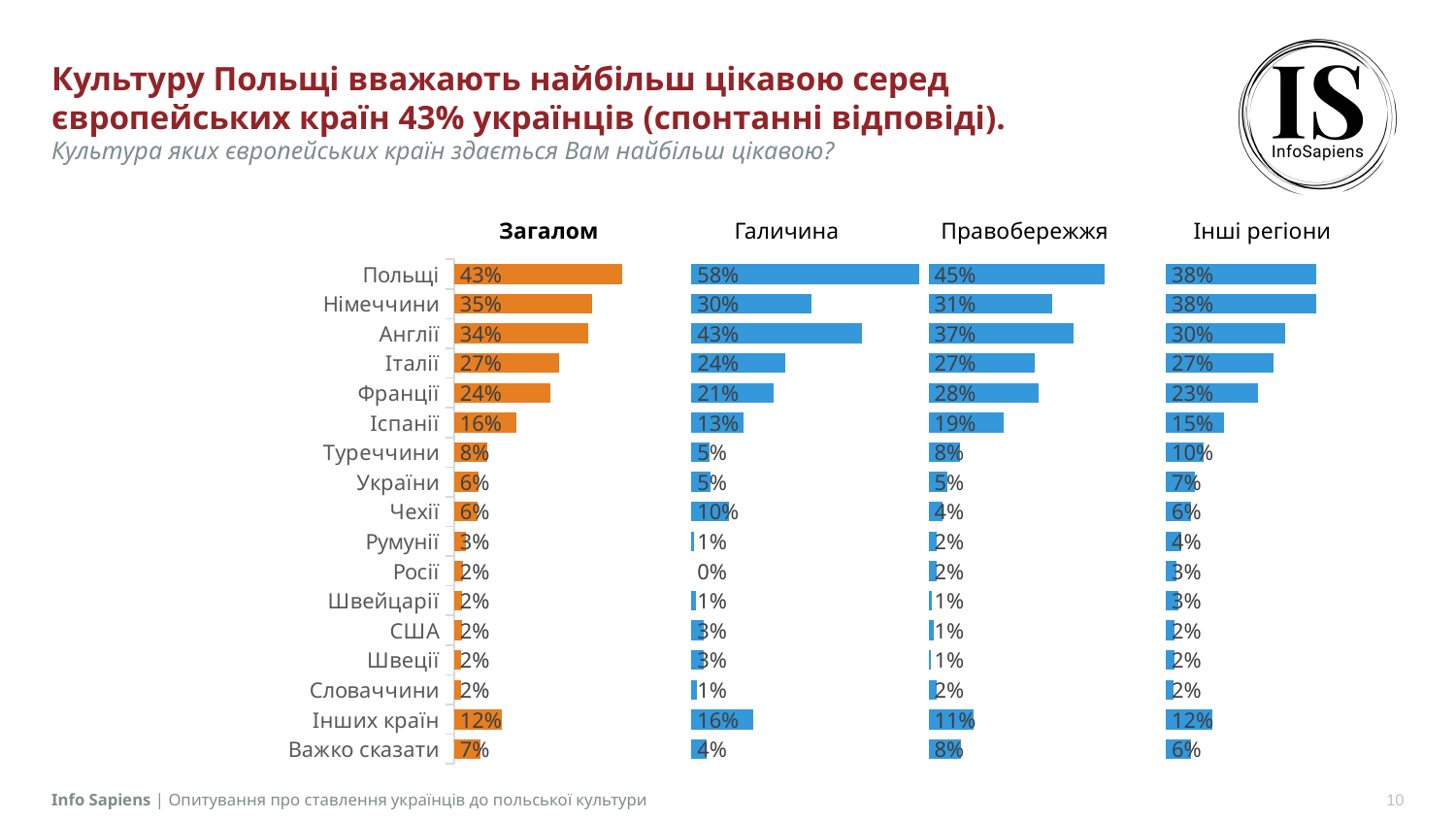
How many categories are listed in the 'Загалом' chart? 17 In the 'Загалом' chart, what is the value for Польщі? 43% In the 'Інші регіони' chart, what is the value for Туреччини? 10% In the 'Загалом' chart, what is the difference between the values for Польщі and Німеччини? 8% How many regional charts are shown on the slide in addition to 'Загалом'? 3 What type of chart is used to show the 'Загалом' data? Bar chart In the 'Правобережжя' chart, what is the value for Франції? 28% In the 'Галичина' chart, which category has the lowest value? Росії In the 'Галичина' chart, what is the value for Англії? 43% In the 'Інші регіони' chart, what is the difference between the values for Польщі and Англії? 8% In the 'Правобережжя' chart, which is larger: the value for Англії or the value for Німеччини? Англії In the 'Галичина' chart, which country has the highest value? Польщі